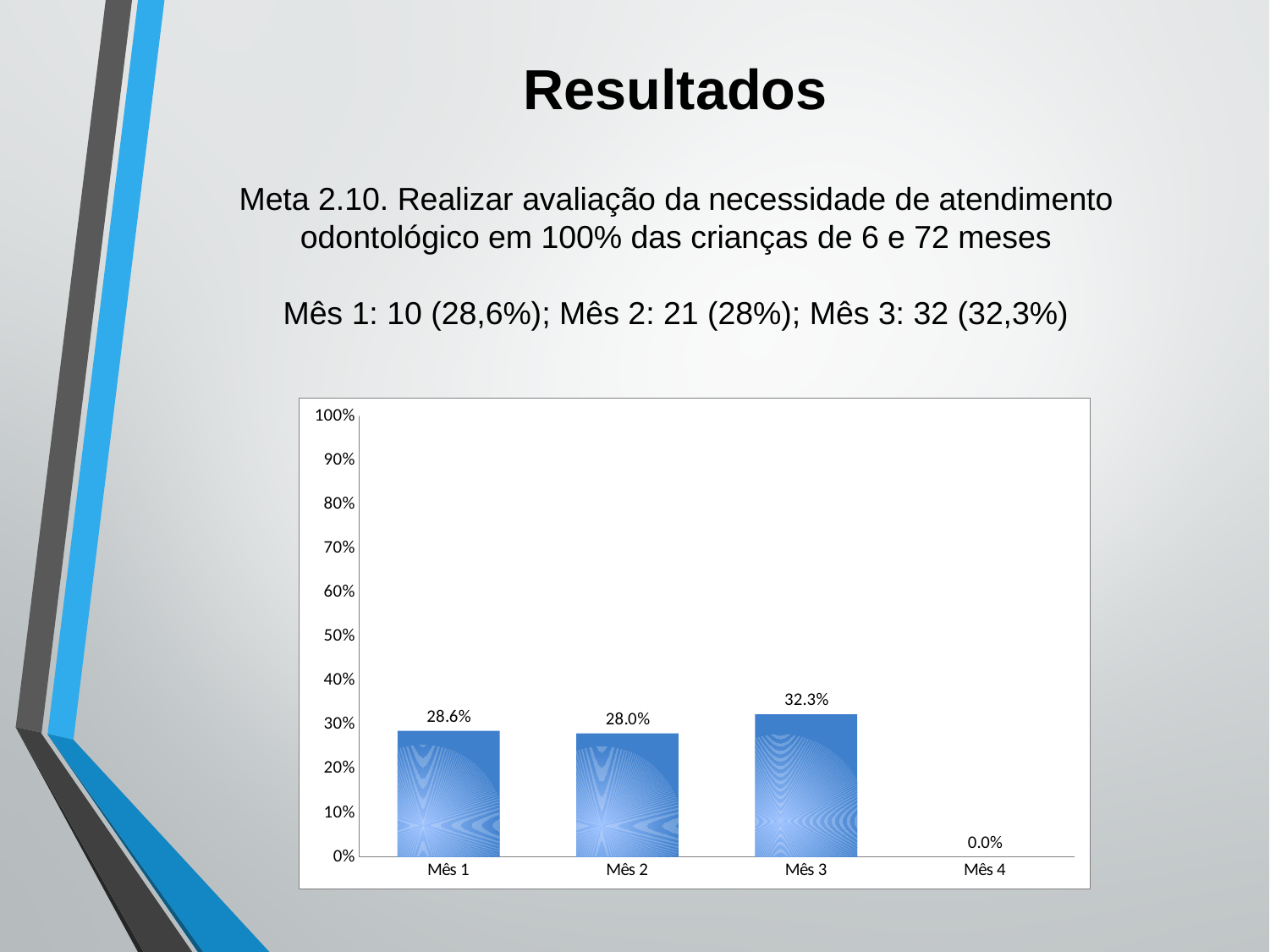
What is the maximum value shown on the y axis? 100% What is the value for Mês 1? 28.6% Which is larger, the value for Mês 1 or the value for Mês 3? Mês 3 How many categories are shown on the x axis? 4 Which category has the highest value? Mês 3 What is the value for Mês 4? 0.0% What is the difference between the values for Mês 3 and Mês 2? 4.3% Which category has the lowest value? Mês 4 Is the value for Mês 3 greater or less than 30%? greater What is the value for Mês 3? 32.3% What kind of chart is shown on the slide? bar chart What is the value for Mês 2? 28.0%